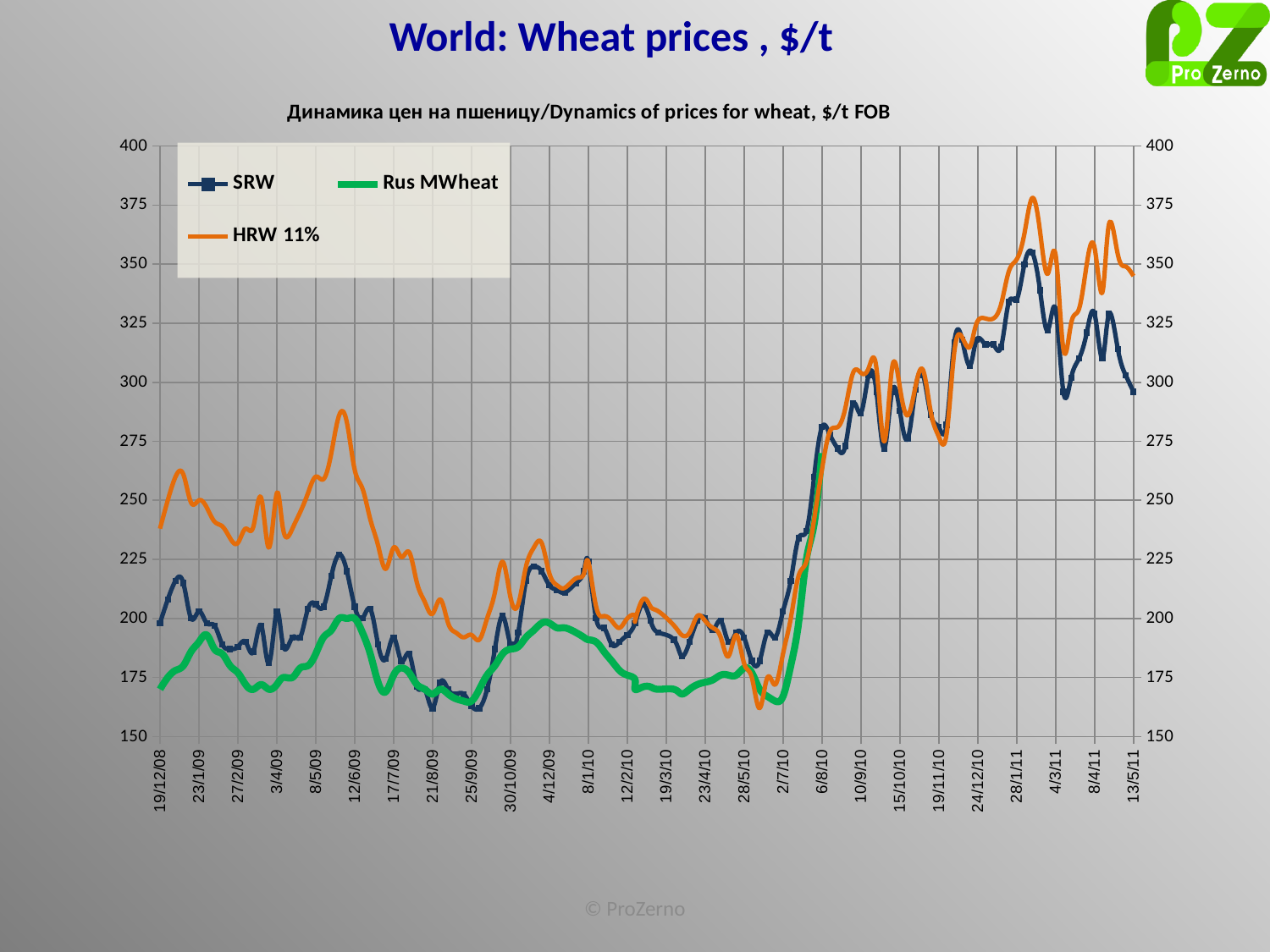
Which series are listed in the chart legend? SRW, Rus MWheat, HRW 11% At 13/5/11, which is higher: HRW 11% or SRW? HRW 11% What colour is the Rus MWheat line? green Is the value for SRW at 13/5/11 greater or less than 275? greater Do the SRW values rise or fall between 2/7/10 and 6/8/10? rise Which series reaches the highest value on the chart? HRW 11% Is the value for Rus MWheat at 19/12/08 greater or less than 200? less Is the value for HRW 11% at 19/12/08 greater or less than 225? greater What kind of chart is shown on the slide? line chart How many series does the legend list? 3 At 19/12/08, which is higher: SRW or HRW 11%? HRW 11%